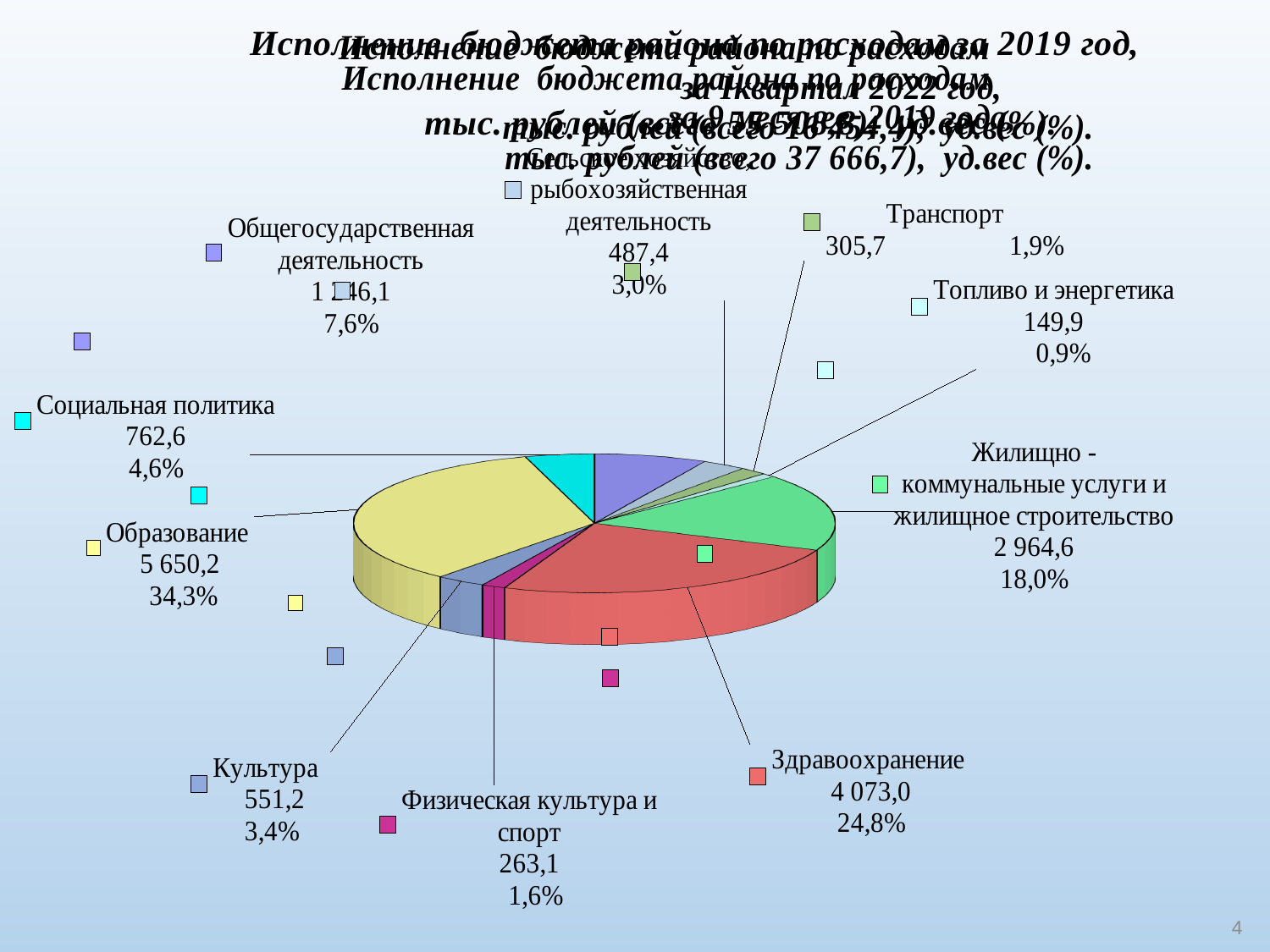
What is the difference between the values for Здравоохранение and Жилищно-коммунальные услуги и жилищное строительство? 1 108,4 What is the value for Здравоохранение? 4 073,0 What share of the pie does Жилищно-коммунальные услуги и жилищное строительство have? 18,0% What is the value for Образование? 5 650,2 Which category has the smallest slice? Топливо и энергетика What is the value for Транспорт? 305,7 What share of the pie does Образование have? 34,3% Which category has the largest slice? Образование What percentage share is shown for Физическая культура и спорт? 1,6% Which is larger, the value for Культура or the value for Социальная политика? Социальная политика What kind of chart is shown on the slide? pie chart How many categories (slices) does the pie chart show? 10